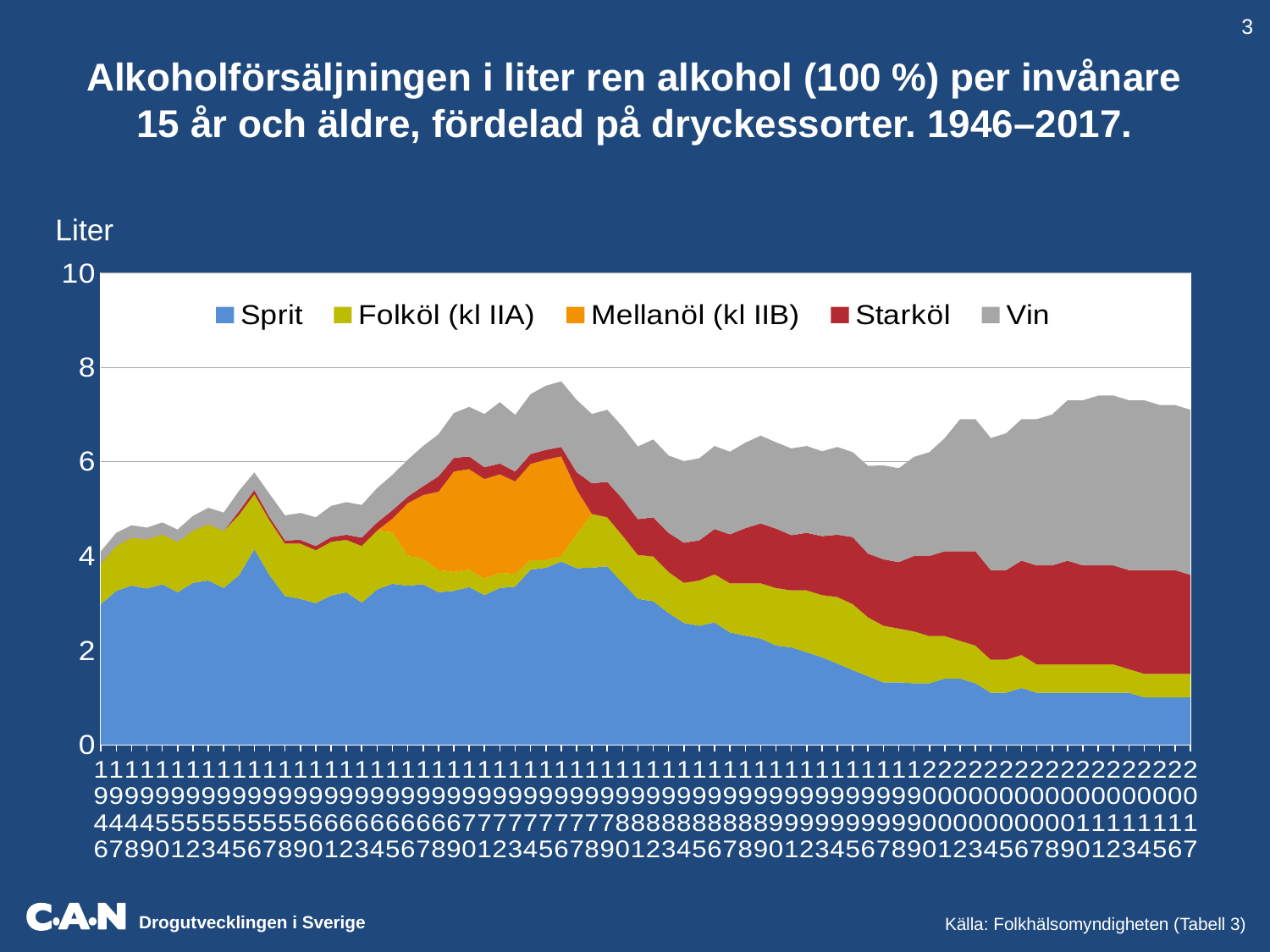
Is the total of all drink types in 1946 greater or less than 6? less Is the value for Sprit in 1946 greater or less than 2? greater How many years are plotted along the x axis? 72 Is the total of all drink types in 2017 greater or less than 6? greater Which is larger, the value for Sprit in 1946 or in 2017? 1946 Does the value for Vin rise or fall from 1946 to 2017? rise Does the value for Sprit rise or fall from 1946 to 2017? fall Which series is shown in orange in the legend? Mellanöl (kl IIB) How many series does the legend list? 5 What is the label on the y axis of the chart? Liter What kind of chart is shown on the slide? stacked area chart